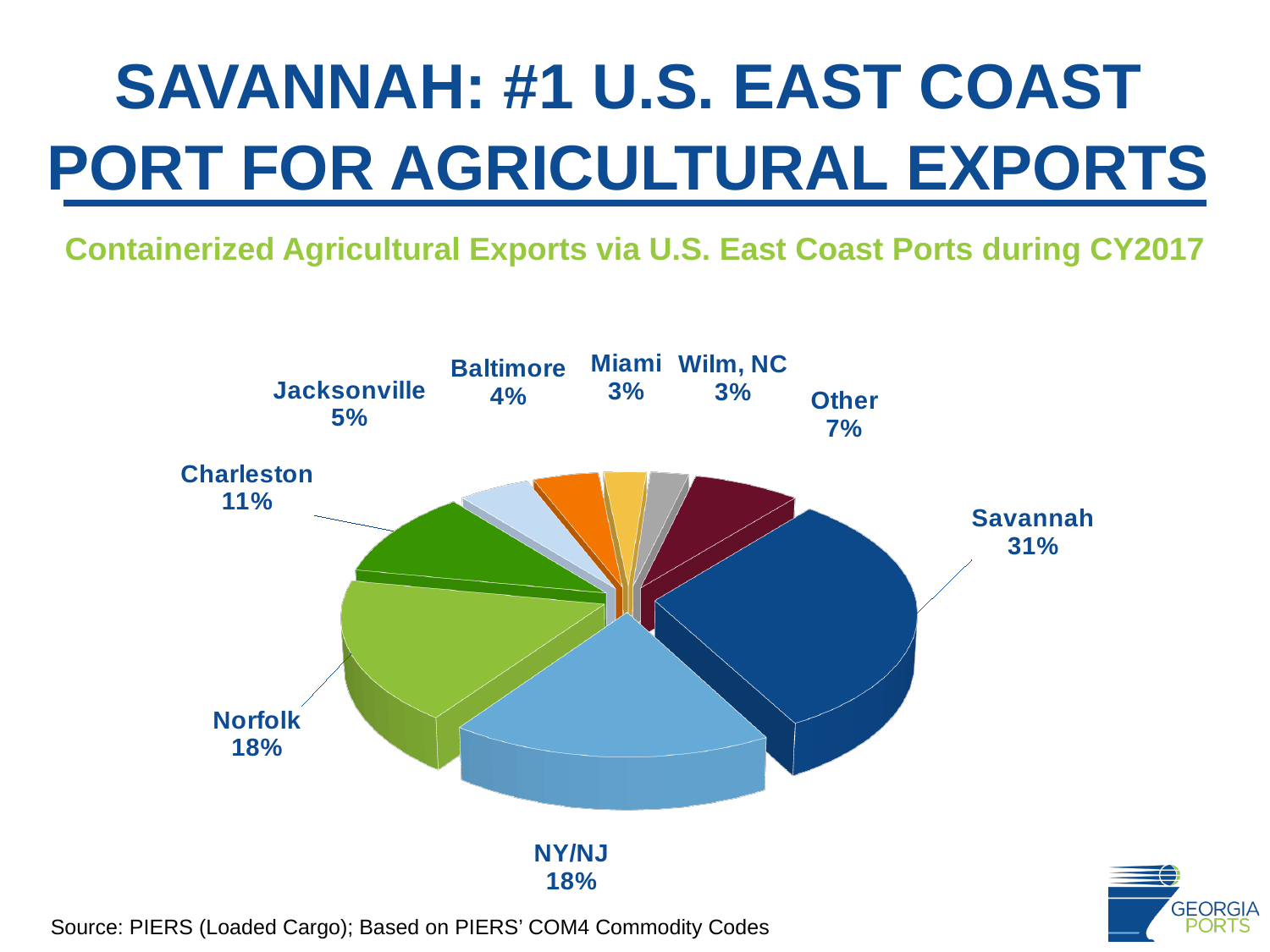
What percentage is shown for Baltimore? 4% What is the combined share of Norfolk and NY/NJ? 36% Which is larger, the share for Other or the share for Jacksonville? Other What is the difference in percentage points between Savannah and Norfolk? 13 What is the subtitle of the chart shown on the slide? Containerized Agricultural Exports via U.S. East Coast Ports during CY2017 What share of containerized agricultural exports does Savannah account for? 31% What kind of chart is shown on the slide? Pie chart Which is larger, the share for Charleston or the share for Baltimore? Charleston How many slices does the pie chart have? 9 What is the difference in percentage points between Charleston and Jacksonville? 6 Which port has the largest slice of the pie? Savannah What percentage is shown for Charleston? 11%